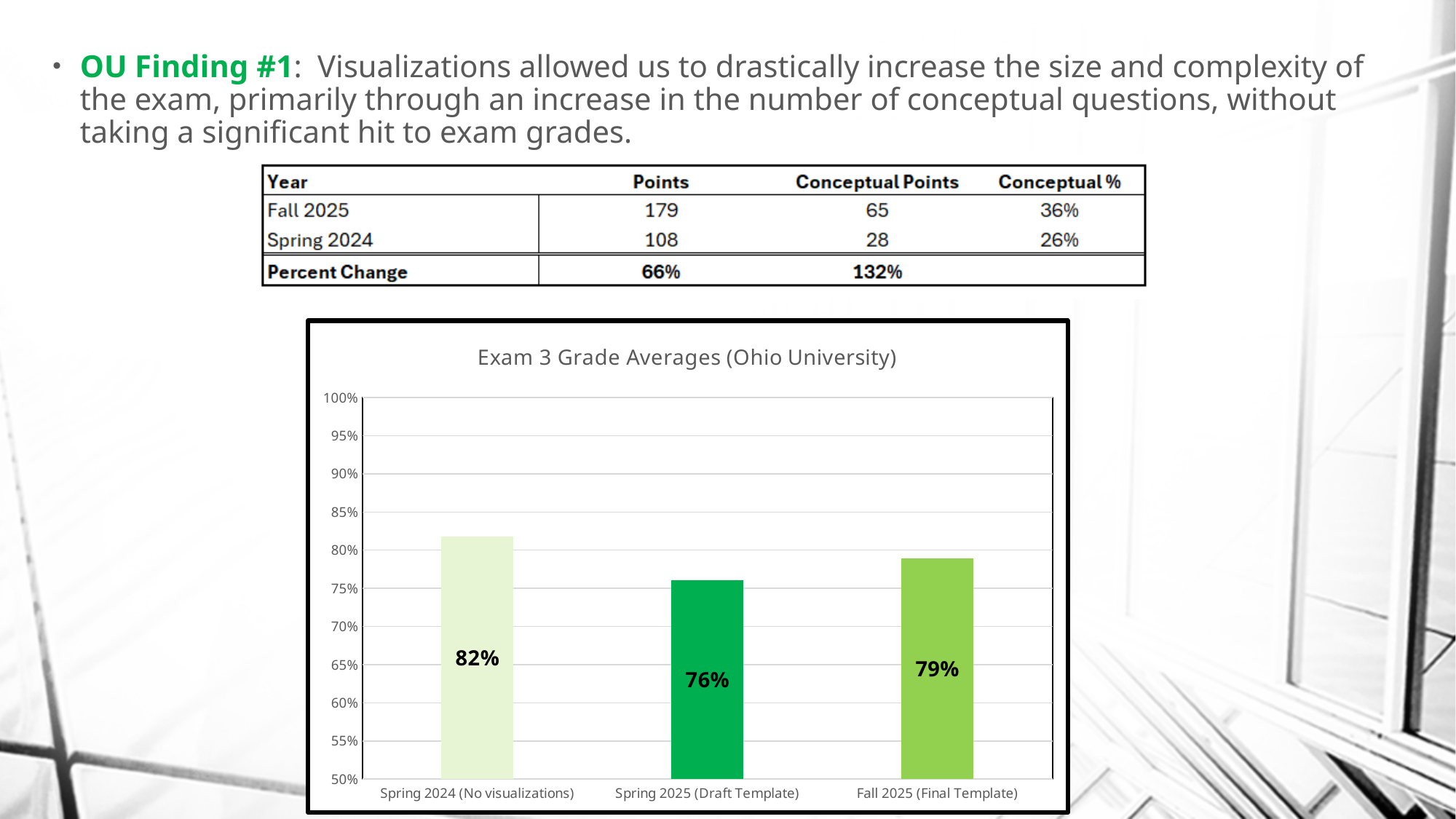
What is the difference between the Spring 2024 (No visualizations) and Fall 2025 (Final Template) averages? 3% What is the exam grade average for Fall 2025 (Final Template)? 79% What type of chart is shown on the slide? bar chart What is the exam grade average for Spring 2025 (Draft Template)? 76% What is the title of the chart? Exam 3 Grade Averages (Ohio University) What is the difference between the Spring 2024 (No visualizations) and Spring 2025 (Draft Template) averages? 6% Is the value for Spring 2025 (Draft Template) greater or less than 80%? less What is the exam grade average for Spring 2024 (No visualizations)? 82% Which category has the highest exam grade average? Spring 2024 (No visualizations) Which category has the lowest exam grade average? Spring 2025 (Draft Template) Which is larger, the average for Spring 2025 (Draft Template) or Fall 2025 (Final Template)? Fall 2025 (Final Template) How many categories are shown on the x axis of the chart? 3